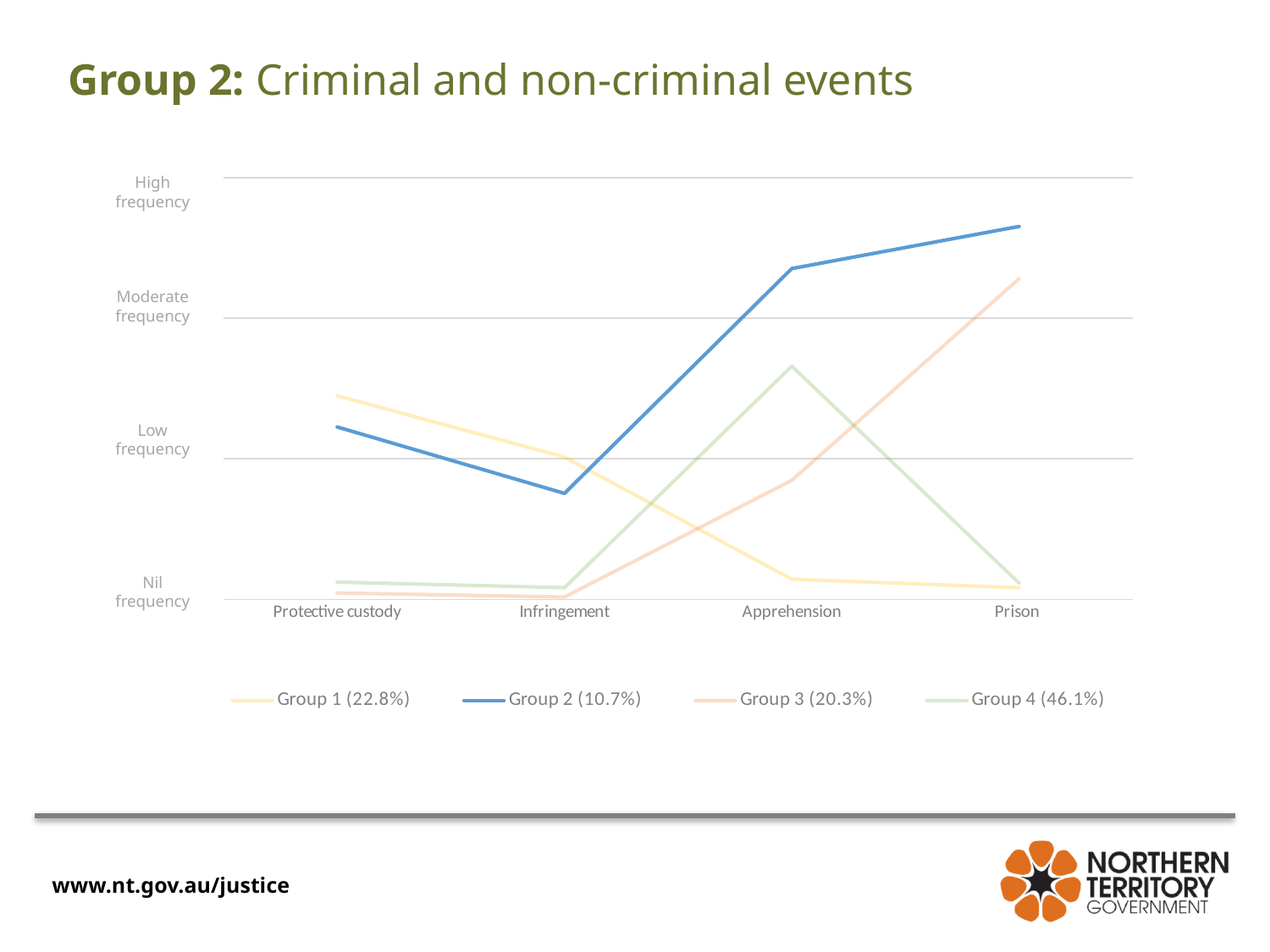
Does the Group 1 line rise or fall from Protective custody to Prison? fall For Prison, which is higher: Group 2 or Group 3? Group 2 For Apprehension, which is higher: Group 4 or Group 3? Group 4 How many series does the legend list? 4 What percentage is shown in the legend for Group 4? 46.1% Which group has the highest frequency for Prison? Group 2 (10.7%) Is the value for Group 2 at Prison above or below the Moderate frequency line? above Which group has the highest frequency for Protective custody? Group 1 (22.8%) How many event categories are shown on the x axis? 4 Which group has the lowest frequency for Apprehension? Group 1 (22.8%) What kind of chart is shown on the slide? Line chart Which group has the highest frequency for Apprehension? Group 2 (10.7%)